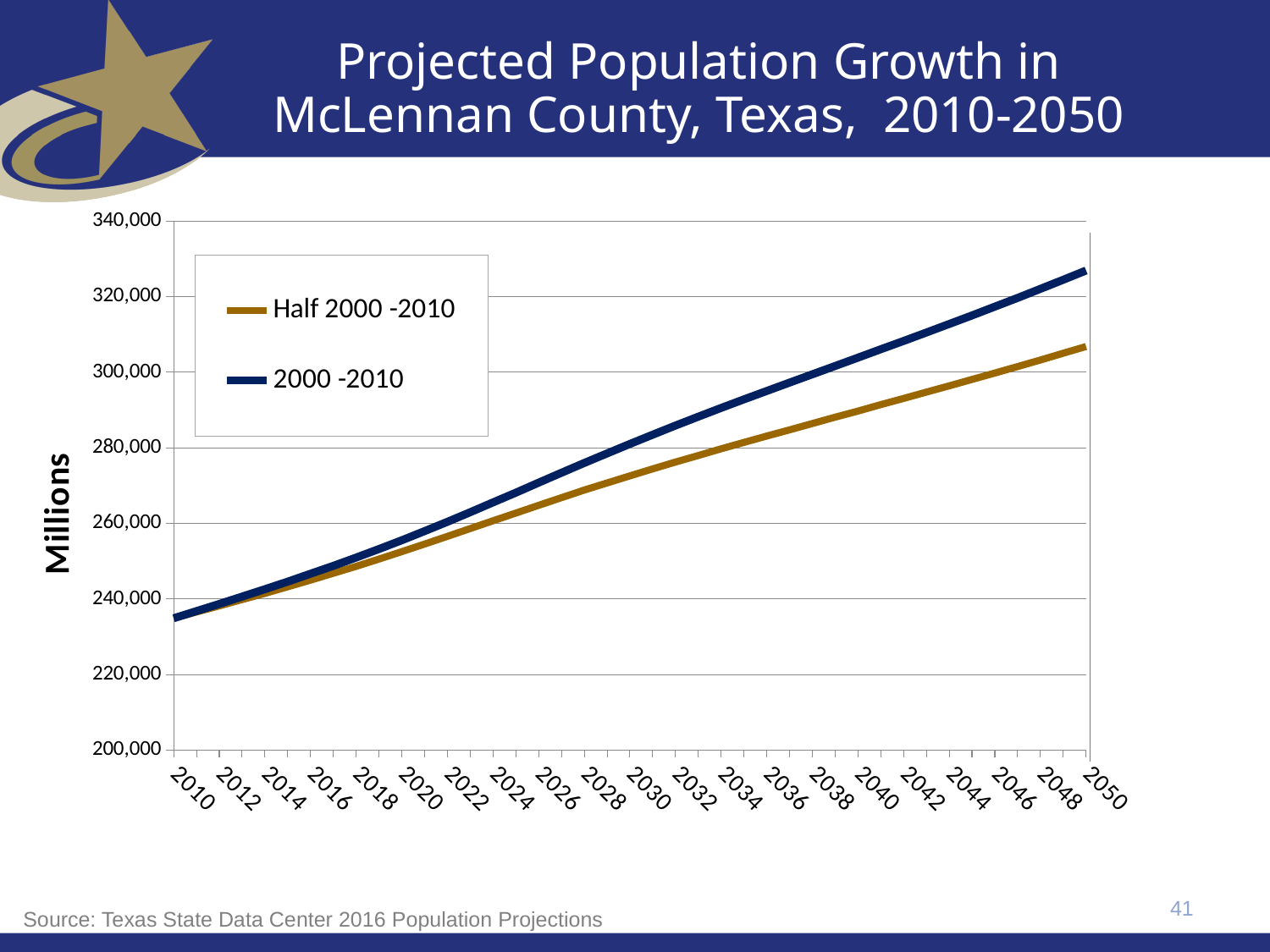
In 2050, which series has the higher value, 2000 -2010 or Half 2000 -2010? 2000 -2010 Do the values for the Half 2000 -2010 series rise or fall from 2010 to 2050? rise Is the value for the 2000 -2010 series in 2010 greater or less than 240,000? less What are the two series named in the legend? Half 2000 -2010 and 2000 -2010 How many series does the legend list? 2 Is the value for the Half 2000 -2010 series in 2050 greater or less than 320,000? less Is the value for the Half 2000 -2010 series in 2050 greater or less than 300,000? greater Do the values for the 2000 -2010 series rise or fall from 2010 to 2050? rise How many year labels are shown along the x axis? 21 What is the label on the vertical axis? Millions What kind of chart is shown on the slide? line chart